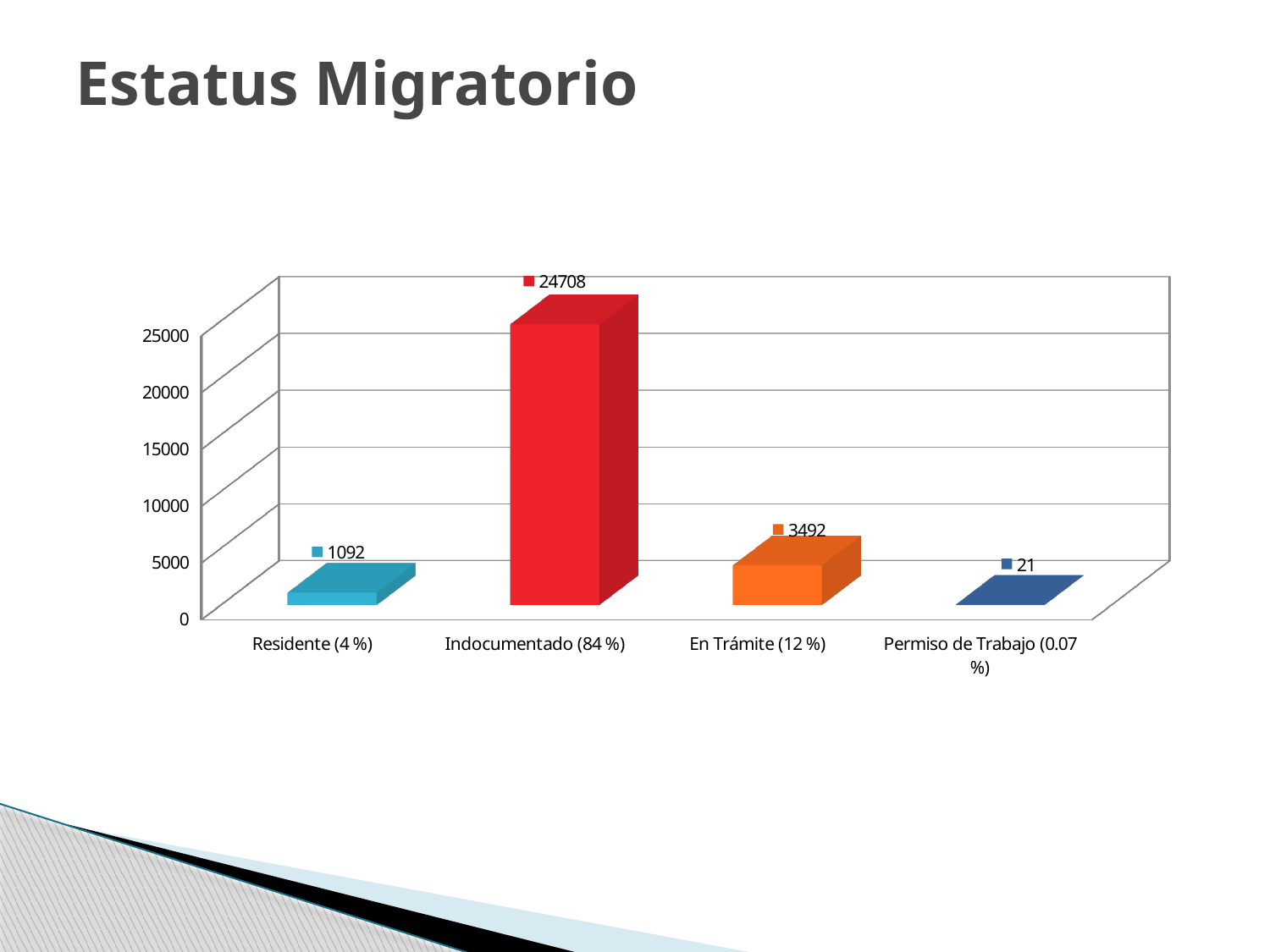
What is the value for En Trámite (12 %)? 3492 What is the difference between the values for Indocumentado (84 %) and En Trámite (12 %)? 21216 Which category has the highest value? Indocumentado (84 %) How many categories are shown on the x axis? 4 What is the difference between the values for En Trámite (12 %) and Residente (4 %)? 2400 What is the value for Indocumentado (84 %)? 24708 What is the value for Residente (4 %)? 1092 Which is larger, the value for Residente (4 %) or the value for En Trámite (12 %)? En Trámite (12 %) What kind of chart is shown on the slide? bar chart Which category has the lowest value? Permiso de Trabajo (0.07 %) What is the value for Permiso de Trabajo (0.07 %)? 21 What is the title of the slide containing the chart? Estatus Migratorio